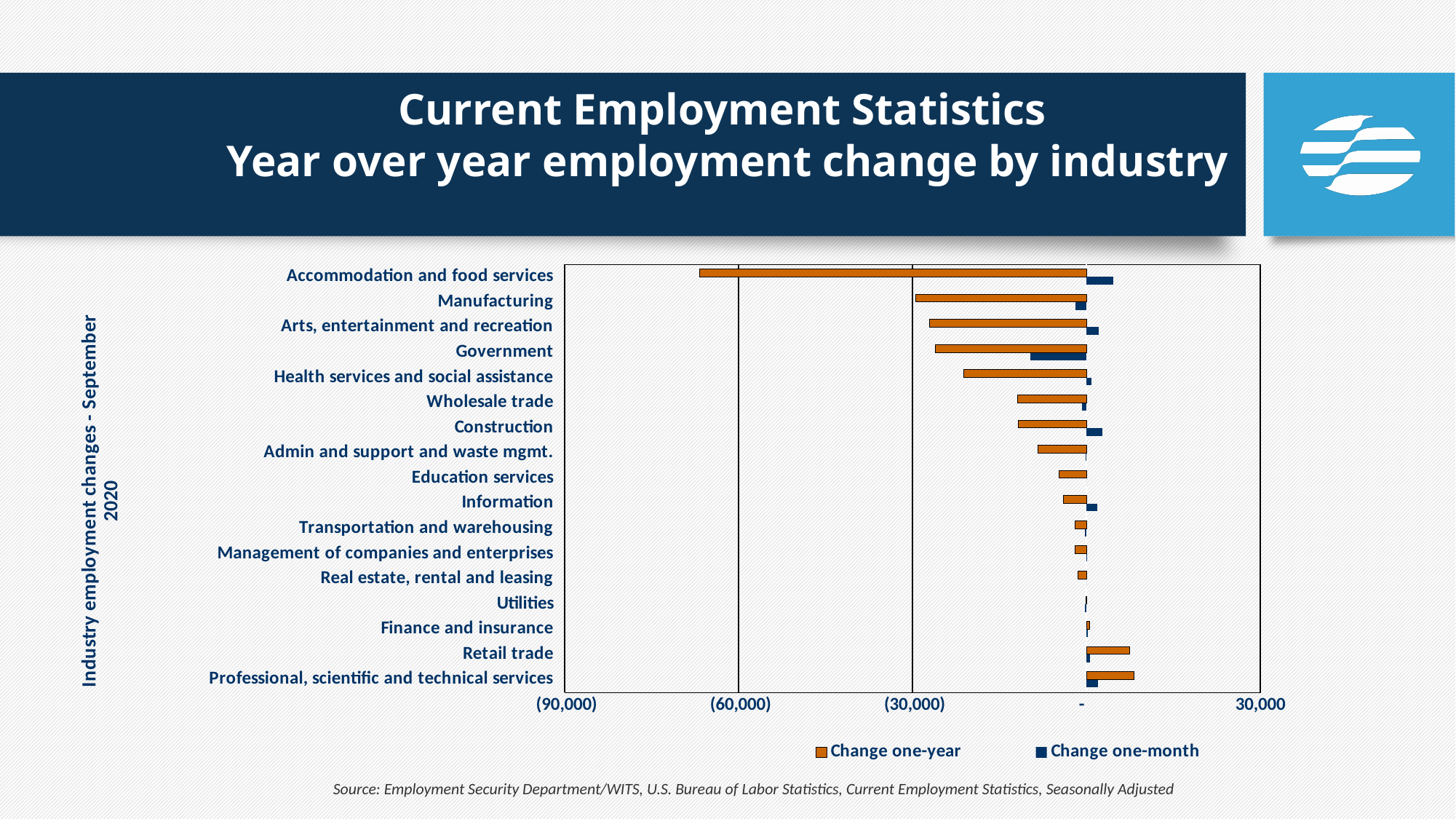
Is the one-year change for Accommodation and food services greater or less than (60,000)? less Is the one-year change for Retail trade greater or less than zero? greater What are the two series named in the legend? Change one-year and Change one-month Which industry has the highest one-month employment change? Accommodation and food services How many industries are plotted on the chart? 17 Which industry has the largest one-month employment decline? Government What type of chart is shown on the slide? Bar chart Is the one-year change for Health services and social assistance greater or less than (30,000)? greater Which industry has the larger one-year employment decline, Accommodation and food services or Manufacturing? Accommodation and food services Which industry has the lowest (most negative) one-year employment change? Accommodation and food services How many series does the legend list? 2 Which series is shown in orange? Change one-year